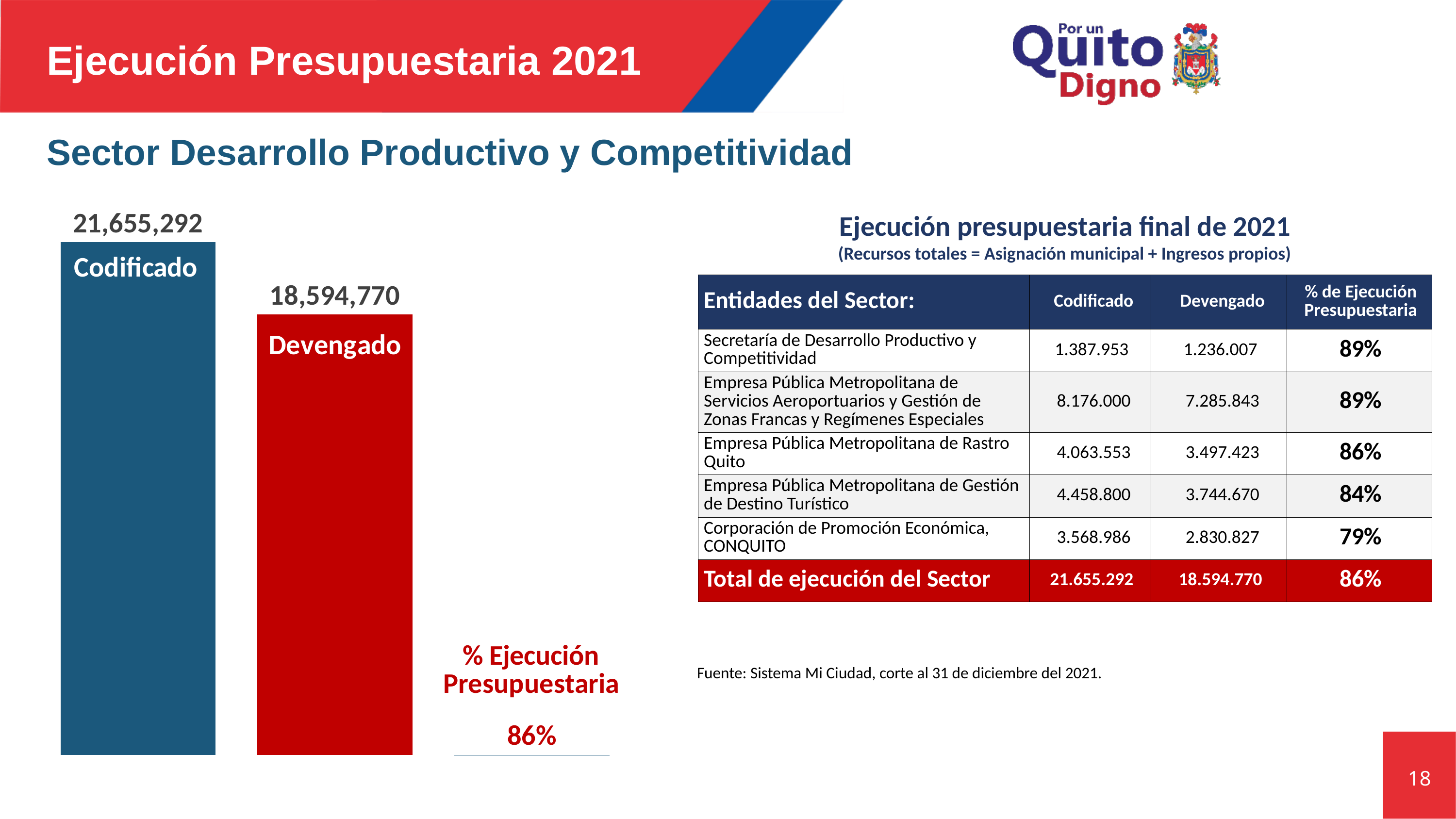
Which bar is the lowest in the bar chart? Devengado What is the value of the Devengado bar? 18,594,770 What is the difference between the Codificado and Devengado bars? 3,060,522 What kind of chart is shown on the left of the slide? Bar chart Which bar is the highest in the bar chart? Codificado What percentage is shown as the % Ejecución Presupuestaria next to the bar chart? 86% What colour is the Devengado bar? Red What is the value of the Codificado bar? 21,655,292 Which is larger, Codificado or Devengado? Codificado How many bars are shown in the bar chart? 2